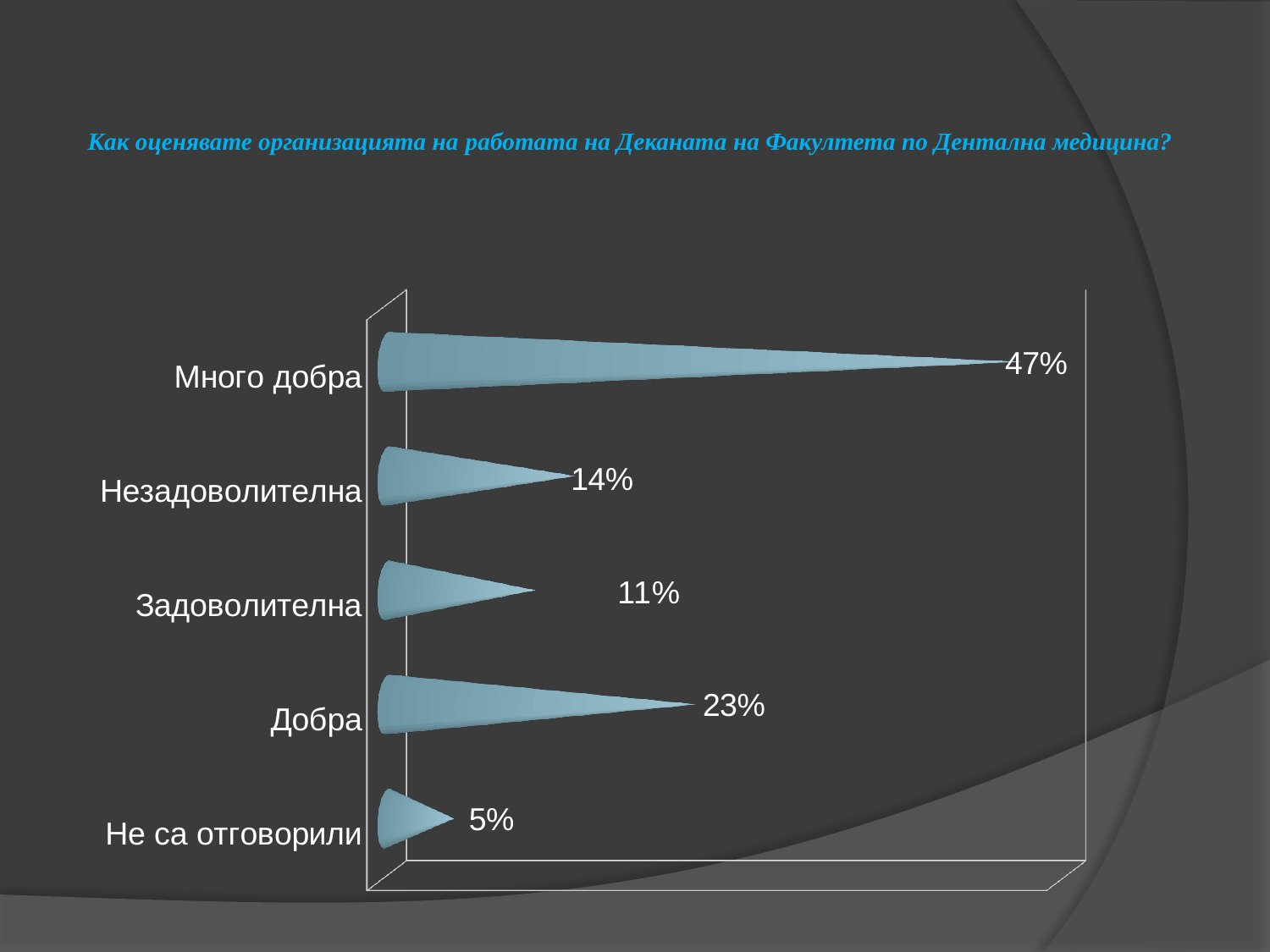
What is the title of the chart? Как оценявате организацията на работата на Деканата на Факултета по Дентална медицина? What kind of chart is shown on the slide? Bar chart Which category has the highest value? Много добра What is the value for Не са отговорили? 5% What is the value for Незадоволителна? 14% Which is larger, the value for Незадоволителна or the value for Задоволителна? Незадоволителна What is the difference between the values for Много добра and Добра? 24% What is the value for Добра? 23% What is the value for Много добра? 47% How many categories are shown in the chart? 5 What is the value for Задоволителна? 11% Which category has the lowest value? Не са отговорили